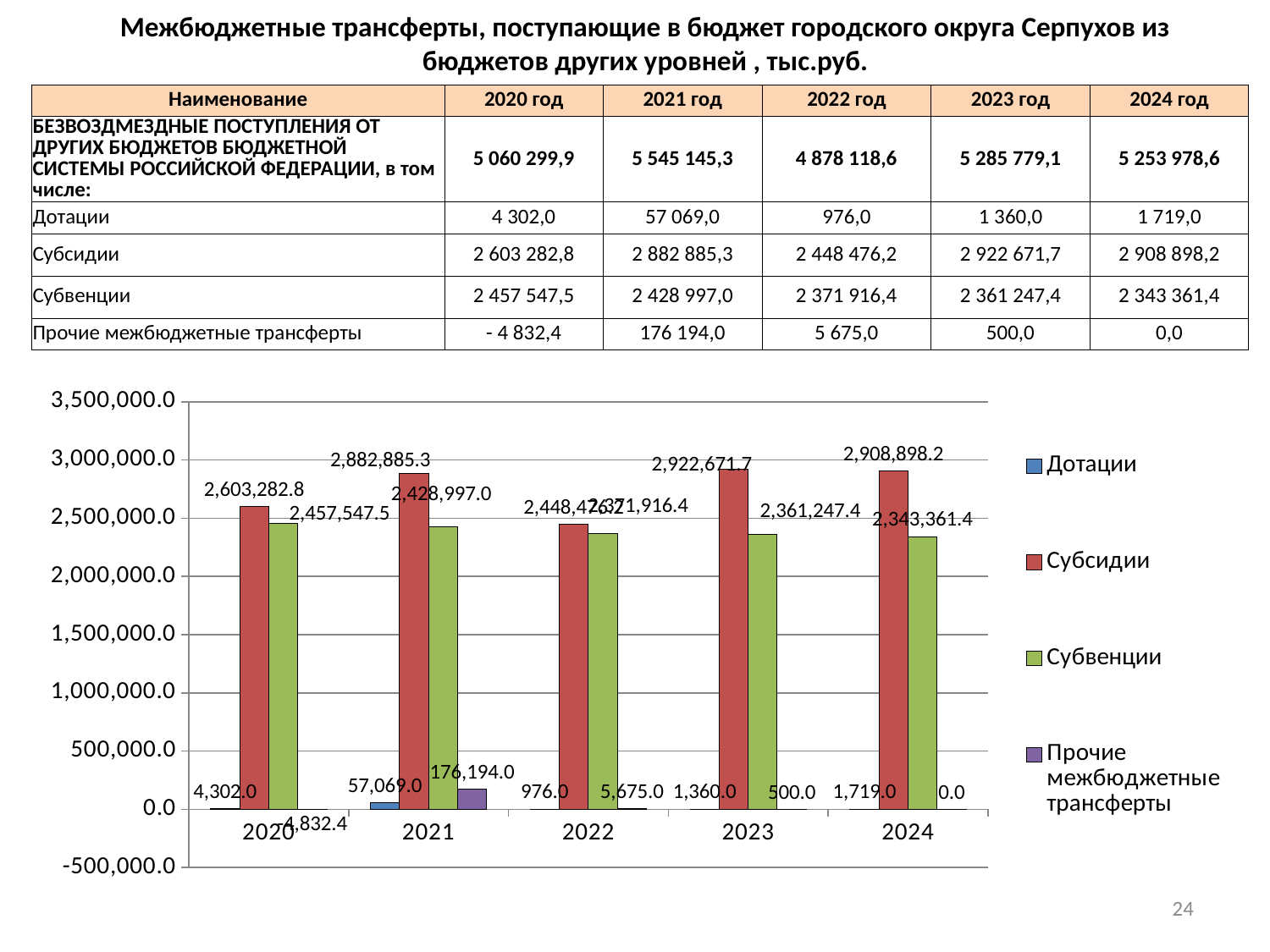
Is the Субсидии value for 2022 greater or less than 2,500,000.0? less How many series does the chart legend list? 4 What is the value of Субсидии for 2021 in the chart? 2,882,885.3 What is the value of Прочие межбюджетные трансферты for 2021 in the chart? 176,194.0 Do the Субвенции values rise or fall from 2020 to 2024 in the chart? fall In which year is the Субсидии value highest in the chart? 2023 In which year is the Субвенции value lowest in the chart? 2024 What is the value of Субвенции for 2024 in the chart? 2,343,361.4 What is the difference between the Субсидии values for 2023 and 2024 in the chart? 13,773.5 What is the value of Дотации for 2021 in the chart? 57,069.0 How many years are shown on the x axis of the chart? 5 In 2020, which is larger in the chart: Субсидии or Субвенции? Субсидии